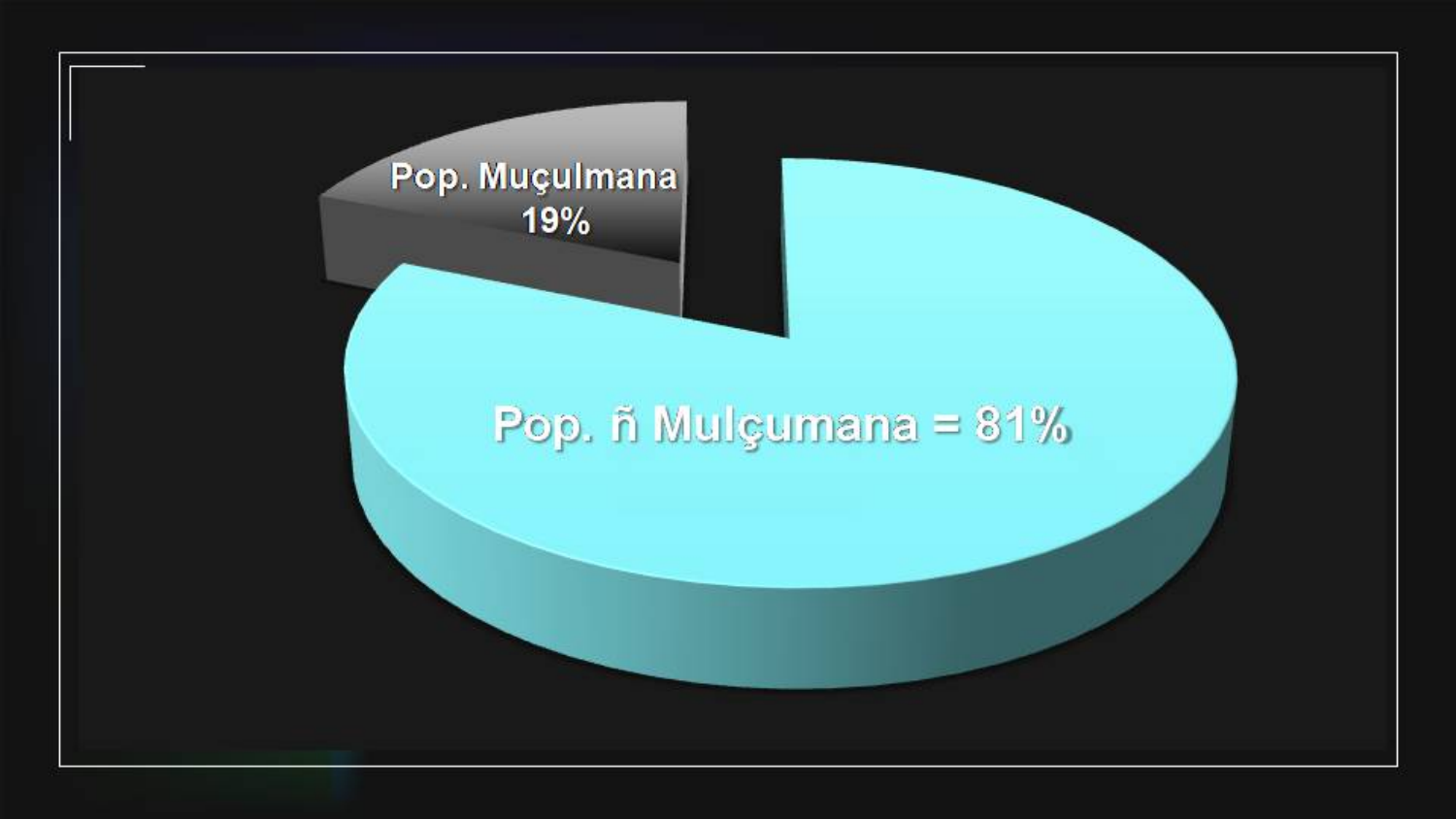
Which slice of the pie is the smallest? Pop. Muçulmana What is the difference in percentage points between the Pop. ñ Mulçumana slice and the Pop. Muçulmana slice? 62 What share of the pie does Pop. ñ Mulçumana represent? 81% What colour is the Pop. ñ Mulçumana slice? light blue Is the share for Pop. Muçulmana greater or less than 50%? less What share of the pie does Pop. Muçulmana represent? 19% What kind of chart is shown on the slide? pie chart What colour is the Pop. Muçulmana slice? grey Which slice of the pie is the largest? Pop. ñ Mulçumana Which is larger, the Pop. Muçulmana slice or the Pop. ñ Mulçumana slice? Pop. ñ Mulçumana How many slices does the pie chart have? 2